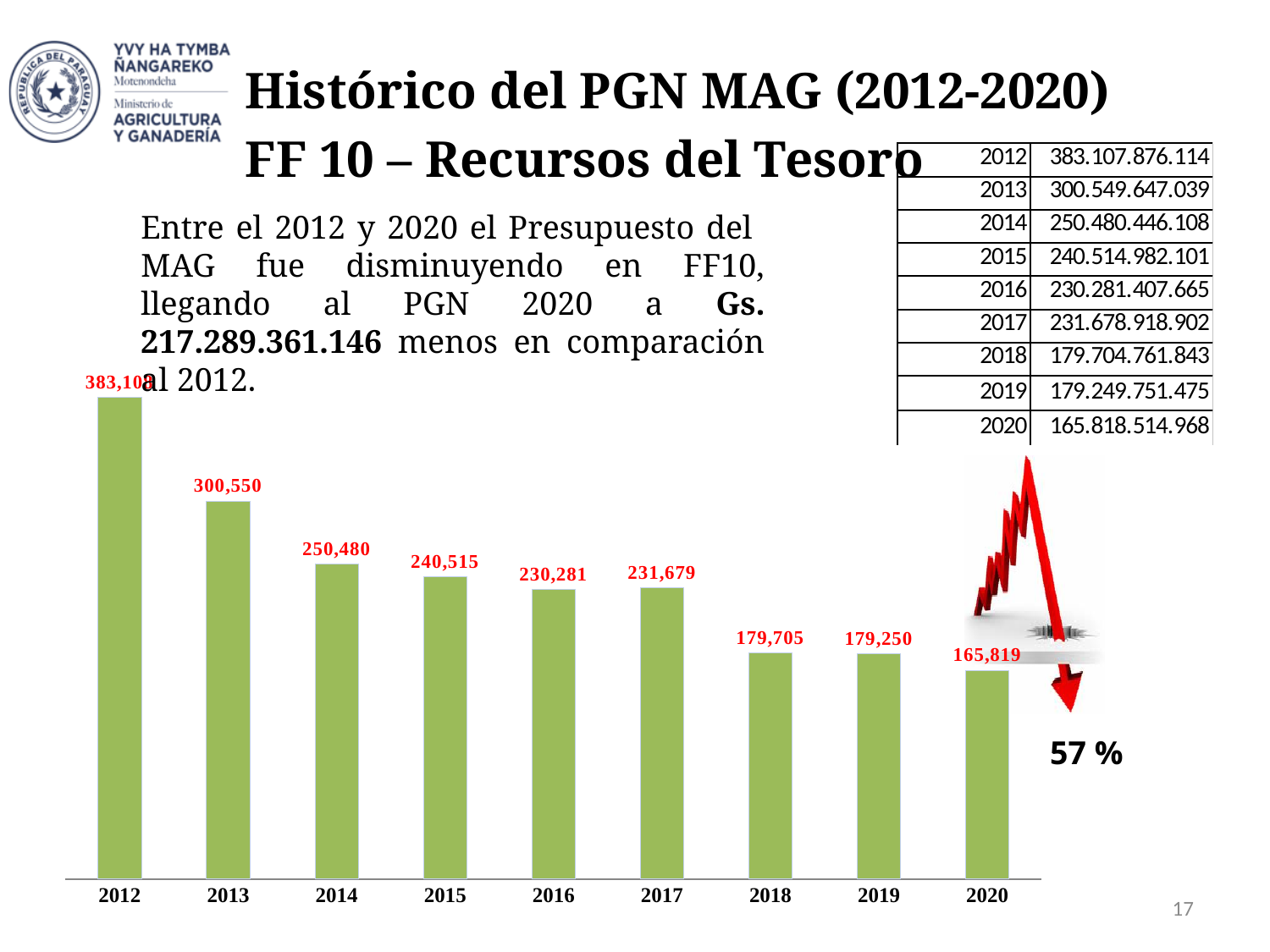
Do the values in the bar chart generally rise or fall from 2012 to 2020? Fall What is the value shown for 2013 in the bar chart? 300,550 Which year has the lowest bar in the chart? 2020 Which year has the larger value in the bar chart, 2016 or 2017? 2017 What kind of chart is shown on the slide? Bar chart What is the difference between the values for 2013 and 2014 in the bar chart? 50,070 What is the value shown for 2017 in the bar chart? 231,679 How many years are shown on the x axis of the bar chart? 9 Which year has the highest bar in the chart? 2012 What is the value shown for 2015 in the bar chart? 240,515 What is the difference between the values for 2018 and 2019 in the bar chart? 455 What is the value shown for 2020 in the bar chart? 165,819